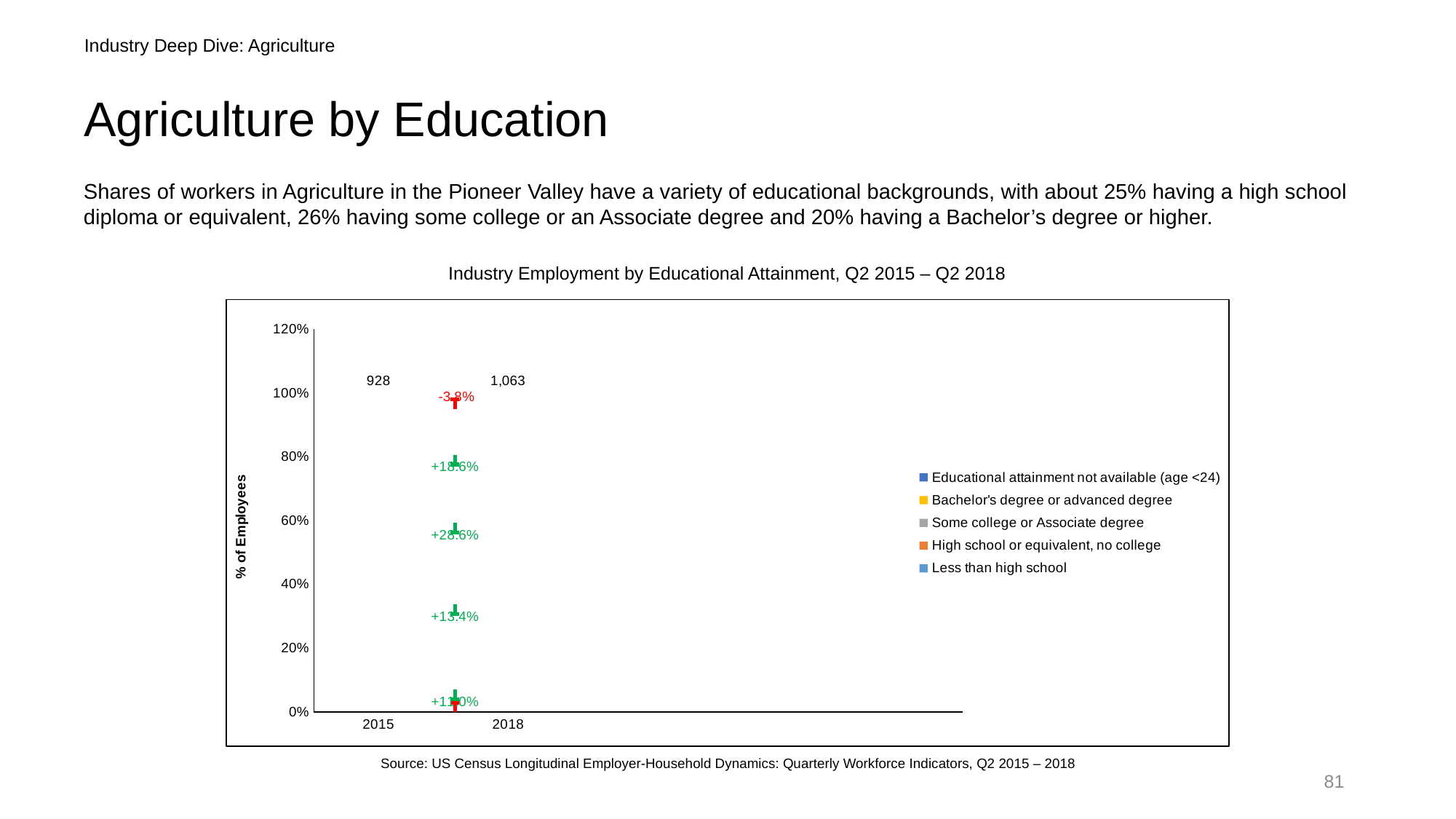
What is the label on the y axis of the chart? % of Employees Which percentage change label on the chart is shown in red (negative)? -3.8% What is the largest percentage change label printed on the chart? +28.6% What total employment figure is printed above the 2015 bar? 928 Which year has the larger total employment figure printed above it, 2015 or 2018? 2018 How many years are shown on the x axis of the chart? 2 What is the difference between the total employment figures printed for 2018 and 2015? 135 What is the title of the chart? Industry Employment by Educational Attainment, Q2 2015 – Q2 2018 How many series does the chart legend list? 5 What is the highest value shown on the y axis of the chart? 120% What total employment figure is printed above the 2018 bar? 1,063